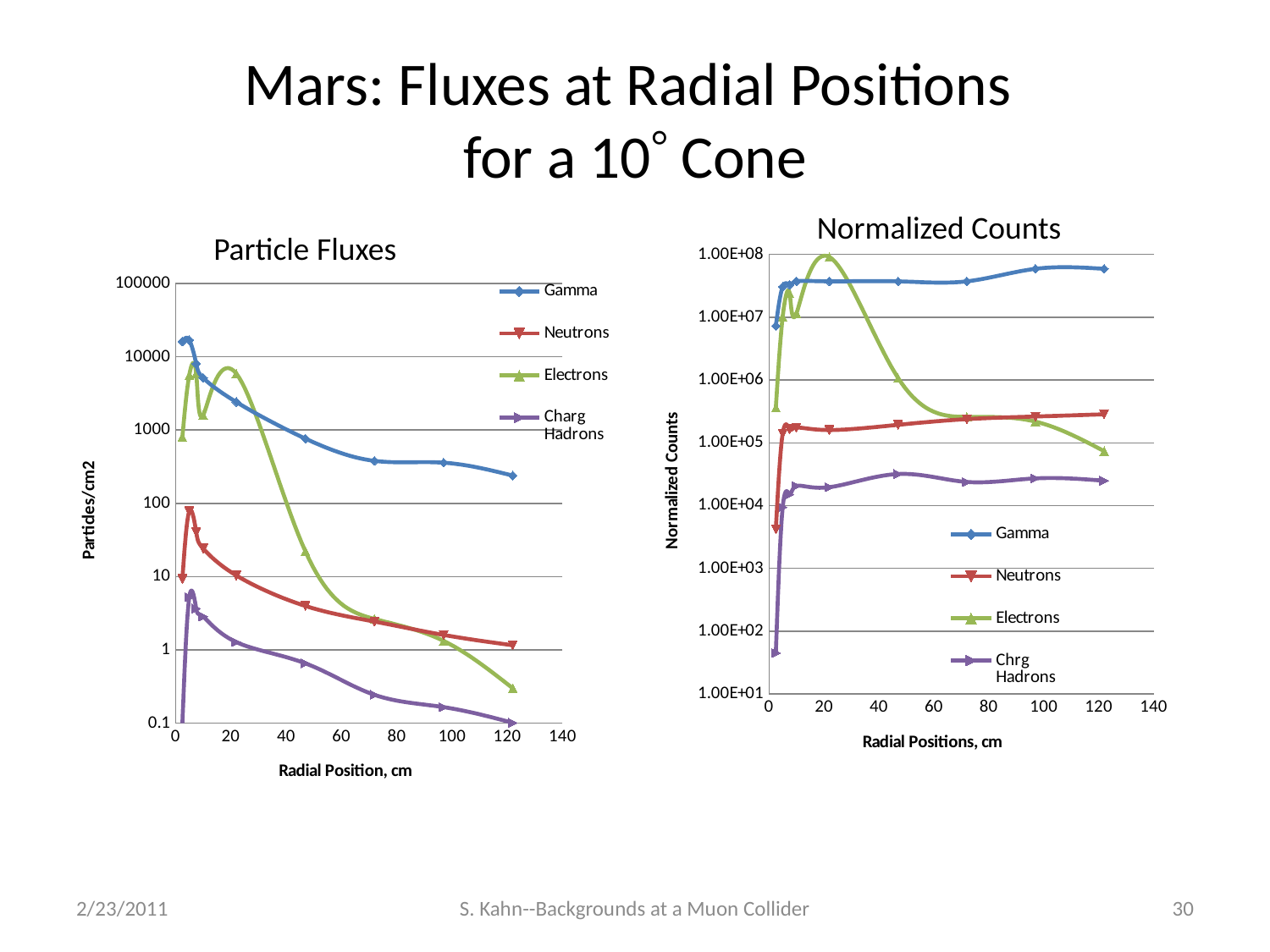
In the Normalized Counts chart, which is larger at 120 cm, Gamma or Electrons? Gamma In the Particle Fluxes chart, is the Electrons value at 120 cm greater or less than 1? less What kind of chart is the Particle Fluxes chart on the left? line chart How many series does the legend of the Particle Fluxes chart list? 4 In the Particle Fluxes chart, is the Gamma value at 120 cm greater or less than 100? greater In the Particle Fluxes chart, is the peak Neutrons value greater or less than 100? less How many series does the legend of the Normalized Counts chart list? 4 What is the x-axis label of the Normalized Counts chart? Radial Positions, cm In the Particle Fluxes chart, which series has the lowest value at 120 cm? Charg Hadrons In the Particle Fluxes chart, which series has the highest value at 120 cm? Gamma